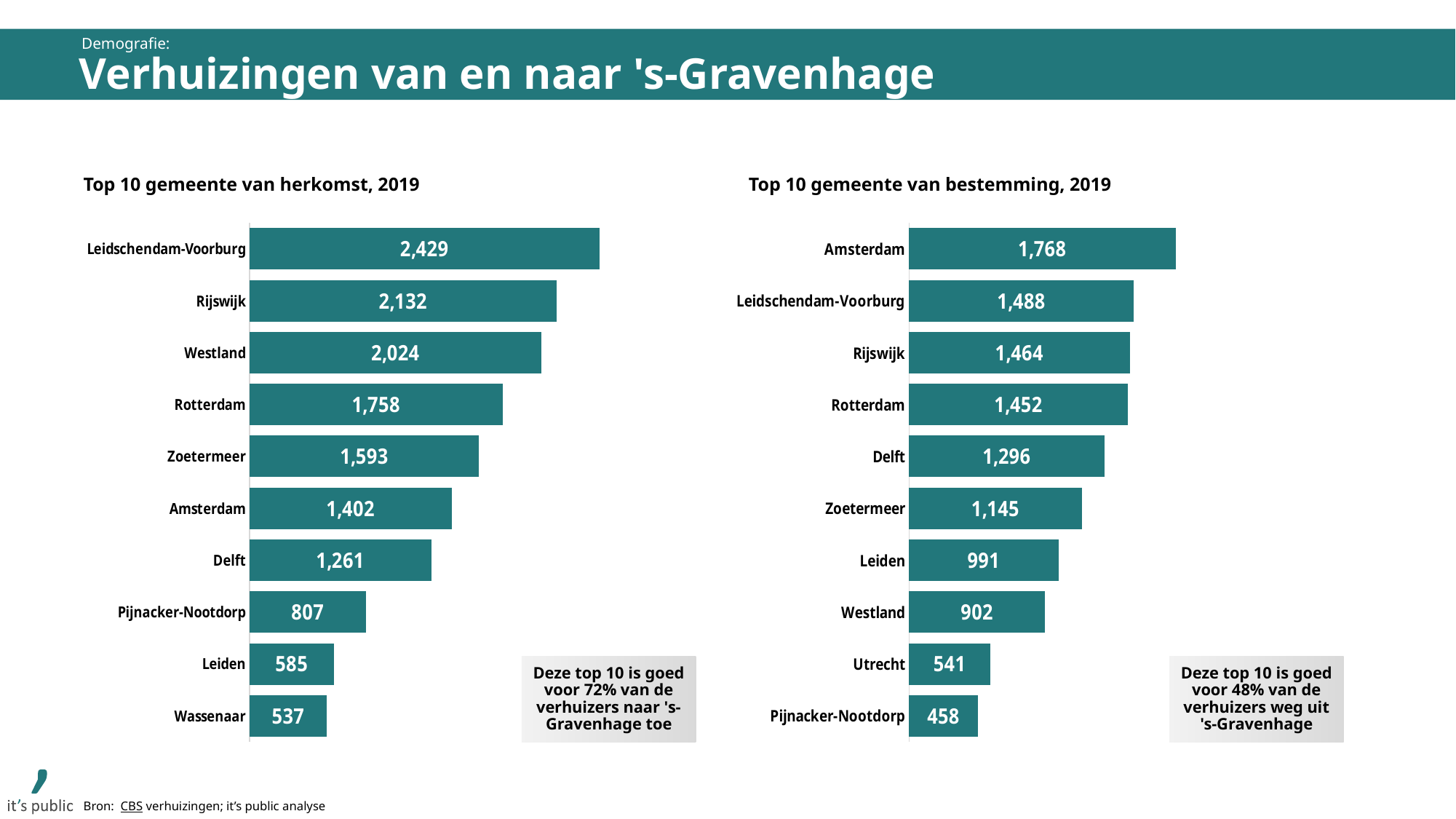
In the chart 'Top 10 gemeente van herkomst, 2019', which is larger: Rotterdam or Zoetermeer? Rotterdam How many gemeenten are shown in the chart 'Top 10 gemeente van herkomst, 2019'? 10 In the chart 'Top 10 gemeente van herkomst, 2019', which gemeente has the highest value? Leidschendam-Voorburg In the chart 'Top 10 gemeente van bestemming, 2019', which is larger: Leiden or Westland? Leiden According to the note on the chart 'Top 10 gemeente van bestemming, 2019', what share of the verhuizers weg uit 's-Gravenhage does this top 10 account for? 48% In the chart 'Top 10 gemeente van bestemming, 2019', what is the difference between Amsterdam and Leidschendam-Voorburg? 280 In the chart 'Top 10 gemeente van bestemming, 2019', what is the value for Delft? 1,296 In the chart 'Top 10 gemeente van herkomst, 2019', what is the value for Wassenaar? 537 In the chart 'Top 10 gemeente van herkomst, 2019', what is the value for Rijswijk? 2,132 In the chart 'Top 10 gemeente van bestemming, 2019', which gemeente has the lowest value? Pijnacker-Nootdorp What kind of chart is 'Top 10 gemeente van bestemming, 2019'? Bar chart In the chart 'Top 10 gemeente van herkomst, 2019', what is the difference between Leidschendam-Voorburg and Rijswijk? 297